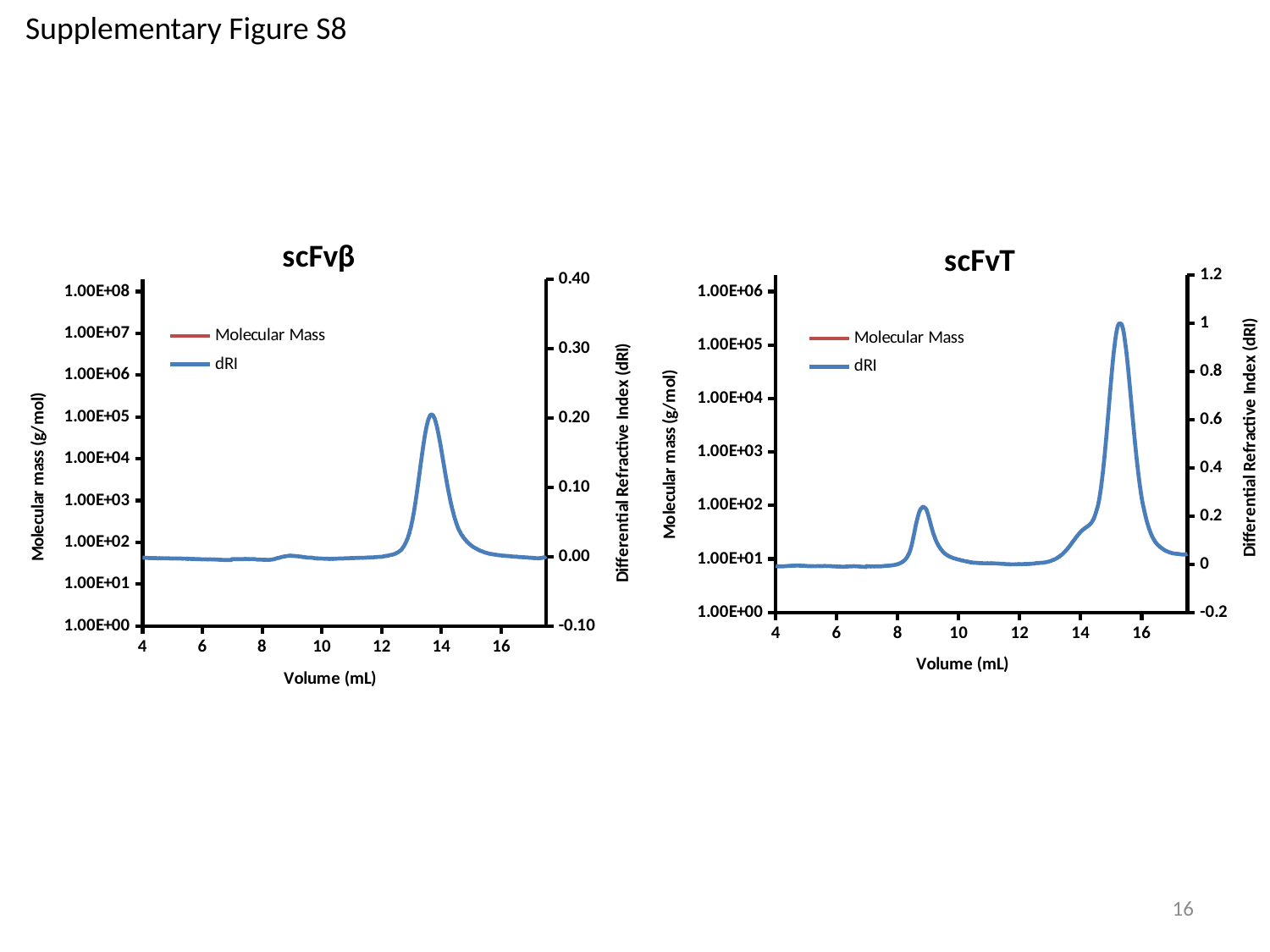
What is the x-axis label of the scFvT chart? Volume (mL) How many series does the legend of the scFvβ chart list? 2 In the scFvT chart, is the peak value of the smaller dRI peak near 9 mL greater or less than 0.4 on the right axis? less In the scFvT chart, is the peak value of the dRI curve near 15 mL greater or less than 0.8 on the right axis? greater What kind of chart is the scFvT chart? line chart What kind of chart is the scFvβ chart? line chart What are the two legend entries in the scFvβ chart? Molecular Mass and dRI How many series does the legend of the scFvT chart list? 2 In the scFvT chart, which dRI peak is higher: the one near 9 mL or the one near 15 mL? the one near 15 mL In the scFvβ chart, is the peak value of the dRI curve (near 14 mL) greater or less than 0.30 on the right axis? less